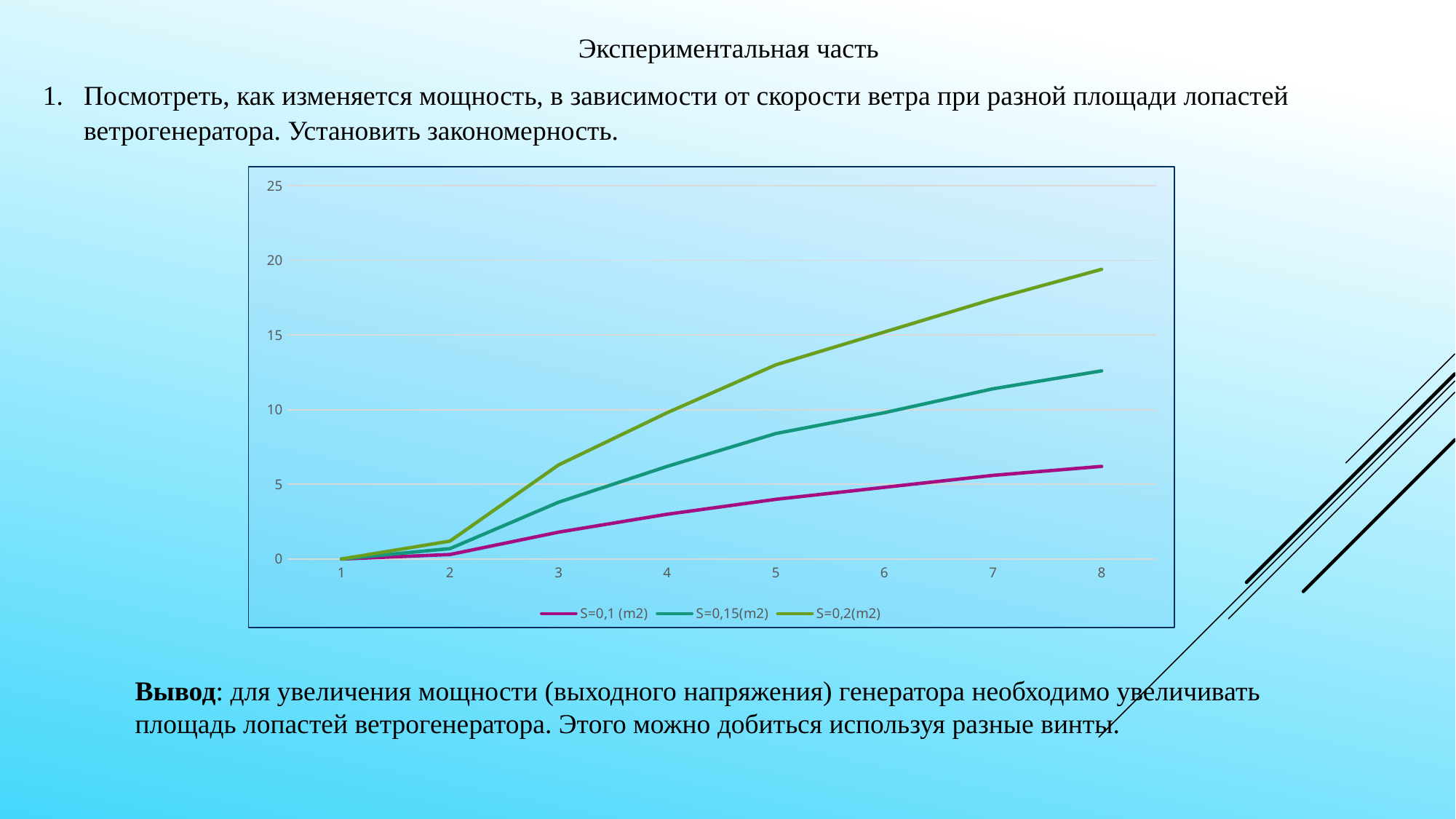
How many series does the chart legend list? 3 Which series has the highest value at x = 8? S=0,2(m2) What are the three series names listed in the chart legend? S=0,1 (m2), S=0,15(m2), S=0,2(m2) Is the value for S=0,2(m2) at x = 5 greater or less than 10? greater What kind of chart is shown on the slide? line chart At x = 5, which is larger: the value for S=0,2(m2) or the value for S=0,15(m2)? S=0,2(m2) Is the value for S=0,15(m2) at x = 8 greater or less than 10? greater Which series has the lowest value at x = 8? S=0,1 (m2) Is the value for S=0,2(m2) at x = 8 greater or less than 15? greater How many points are marked along the x axis of the chart? 8 Do the values of the S=0,2(m2) series rise or fall as the x axis goes from 1 to 8? rise